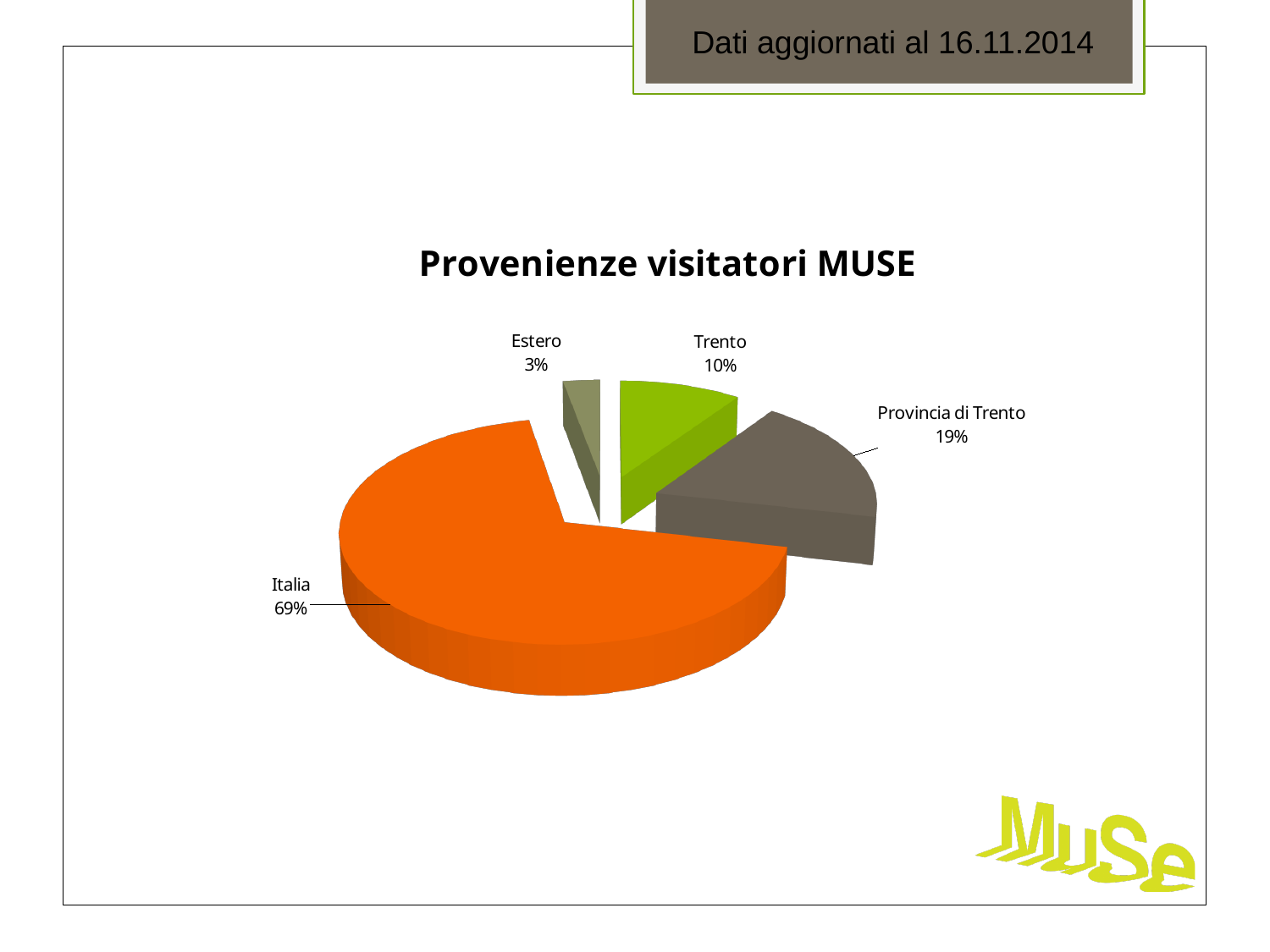
What share of visitors comes from Italia? 69% What kind of chart is shown on the slide? pie chart What share of visitors comes from Trento? 10% What is the title of the chart? Provenienze visitatori MUSE What share of visitors comes from Estero? 3% How many slices does the pie chart have? 4 Which is larger, the share for Trento or the share for Estero? Trento Which category has the smallest slice of the pie? Estero Which category has the largest slice of the pie? Italia What colour is the Italia slice? orange What share of visitors comes from Provincia di Trento? 19% What is the difference in percentage points between Provincia di Trento and Trento? 9